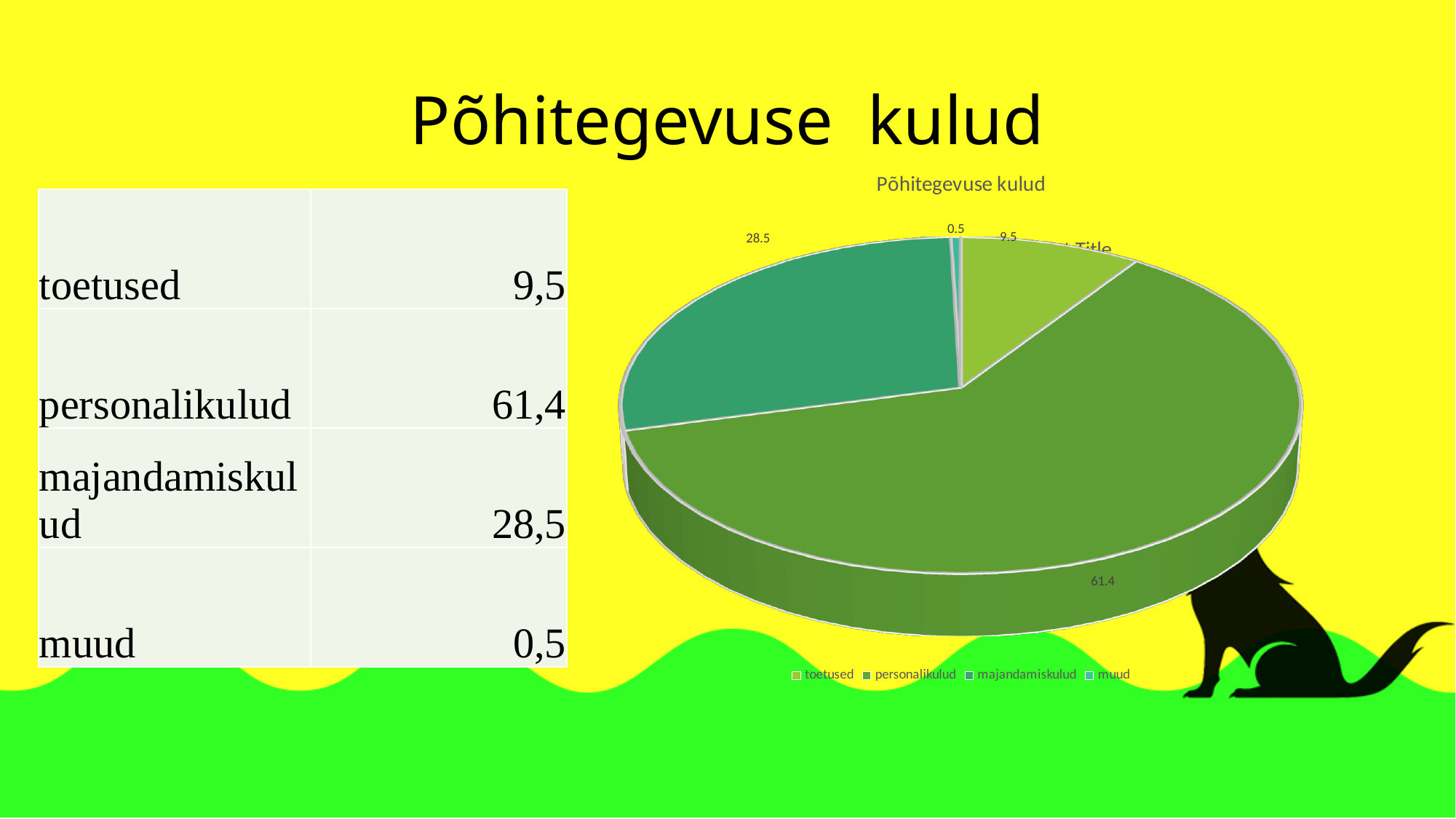
What type of chart is shown on the slide? pie chart What is the value shown for muud in the pie chart? 0.5 Which category has the smallest slice in the pie chart? muud What is the title of the chart? Põhitegevuse kulud How many categories does the pie chart show? 4 What is the value shown for toetused in the pie chart? 9.5 What is the value shown for majandamiskulud in the pie chart? 28.5 What is the difference between the values for personalikulud and majandamiskulud? 32.9 What is the value shown for personalikulud in the pie chart? 61.4 What is the difference between the values for toetused and muud? 9 Which is larger, the slice for majandamiskulud or the slice for toetused? majandamiskulud Which category has the largest slice in the pie chart? personalikulud